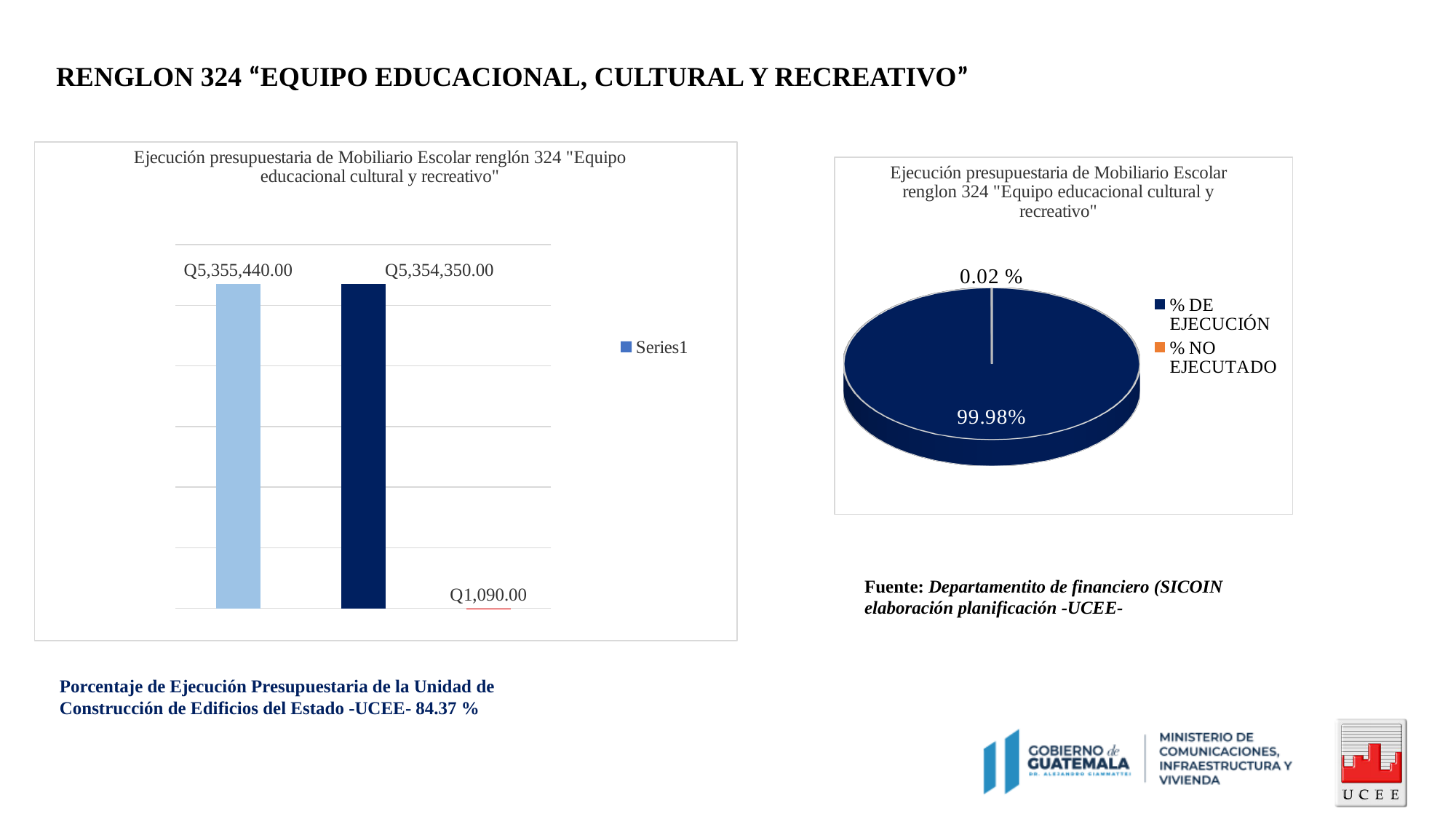
In the bar chart on the left, which is larger: the first bar or the third bar? the first bar In the bar chart on the left, what is the value shown on the first (left-most) bar? Q5,355,440.00 In the bar chart on the left, what is the value shown on the second (middle) bar? Q5,354,350.00 In the pie chart on the right, what share is labelled for "% NO EJECUTADO"? 0.02 % What kind of chart is the chart on the left of the slide? bar chart In the pie chart on the right, what share is labelled for "% DE EJECUCIÓN"? 99.98% How many series does the legend of the bar chart on the left list? 1 How many bars are plotted in the bar chart on the left? 3 In the bar chart on the left, what is the difference between the first bar (Q5,355,440.00) and the second bar (Q5,354,350.00)? Q1,090.00 What kind of chart is the chart on the right of the slide? pie chart In the bar chart on the left, which bar has the lowest value? the third (right-most) bar, Q1,090.00 In the bar chart on the left, what is the value shown on the third (right-most) bar? Q1,090.00